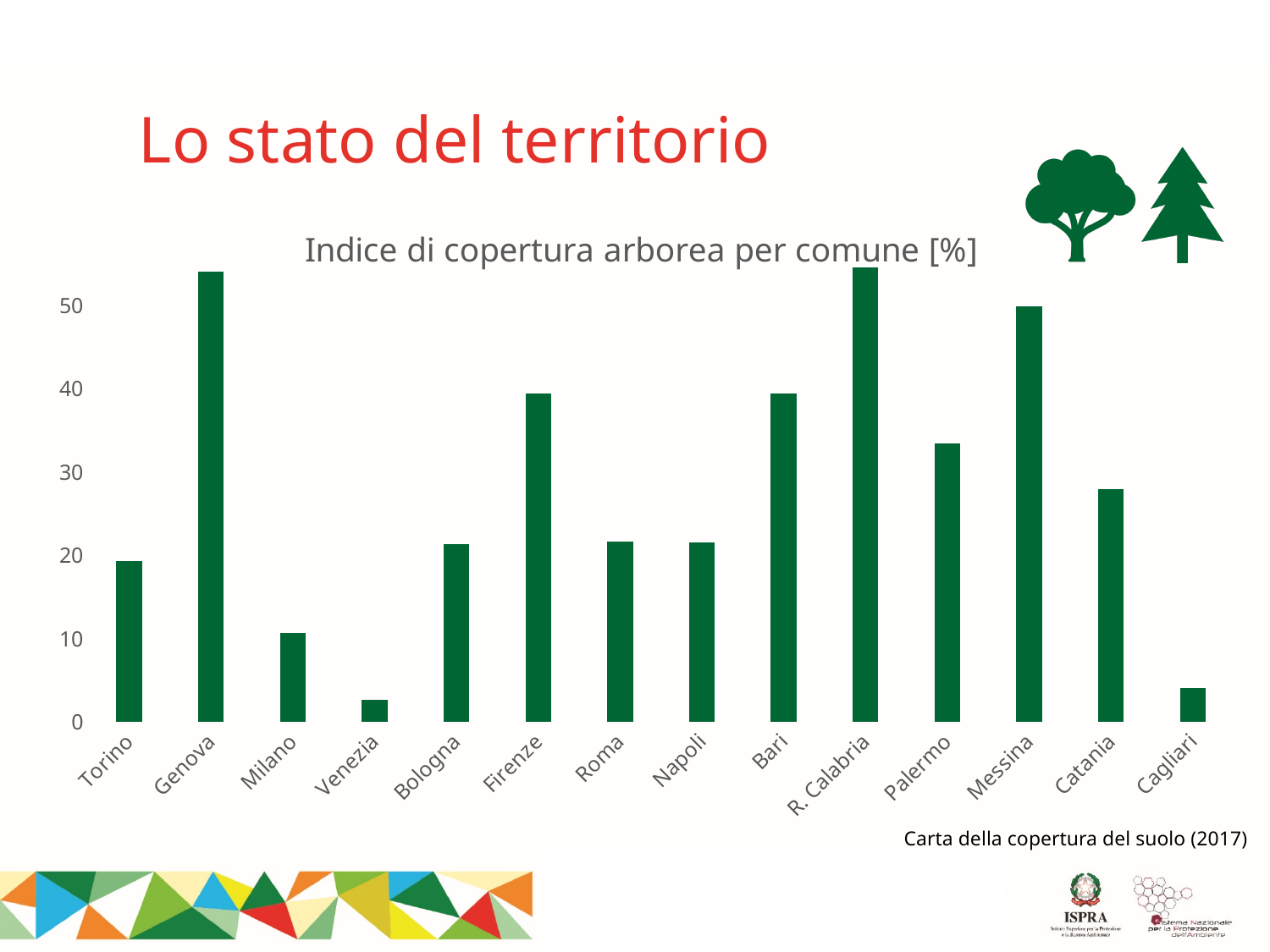
Is the value for Catania greater or less than 30? less Is the value for Genova greater or less than 50? greater How many comuni (cities) are shown on the x axis of the chart? 14 What source is cited below the chart? Carta della copertura del suolo (2017) Is the value for Palermo greater or less than 30? greater Which has a higher tree cover index, Messina or Torino? Messina Which has a higher tree cover index, Genova or Milano? Genova What kind of chart is shown on the slide? bar chart What is the title of the chart? Indice di copertura arborea per comune [%]